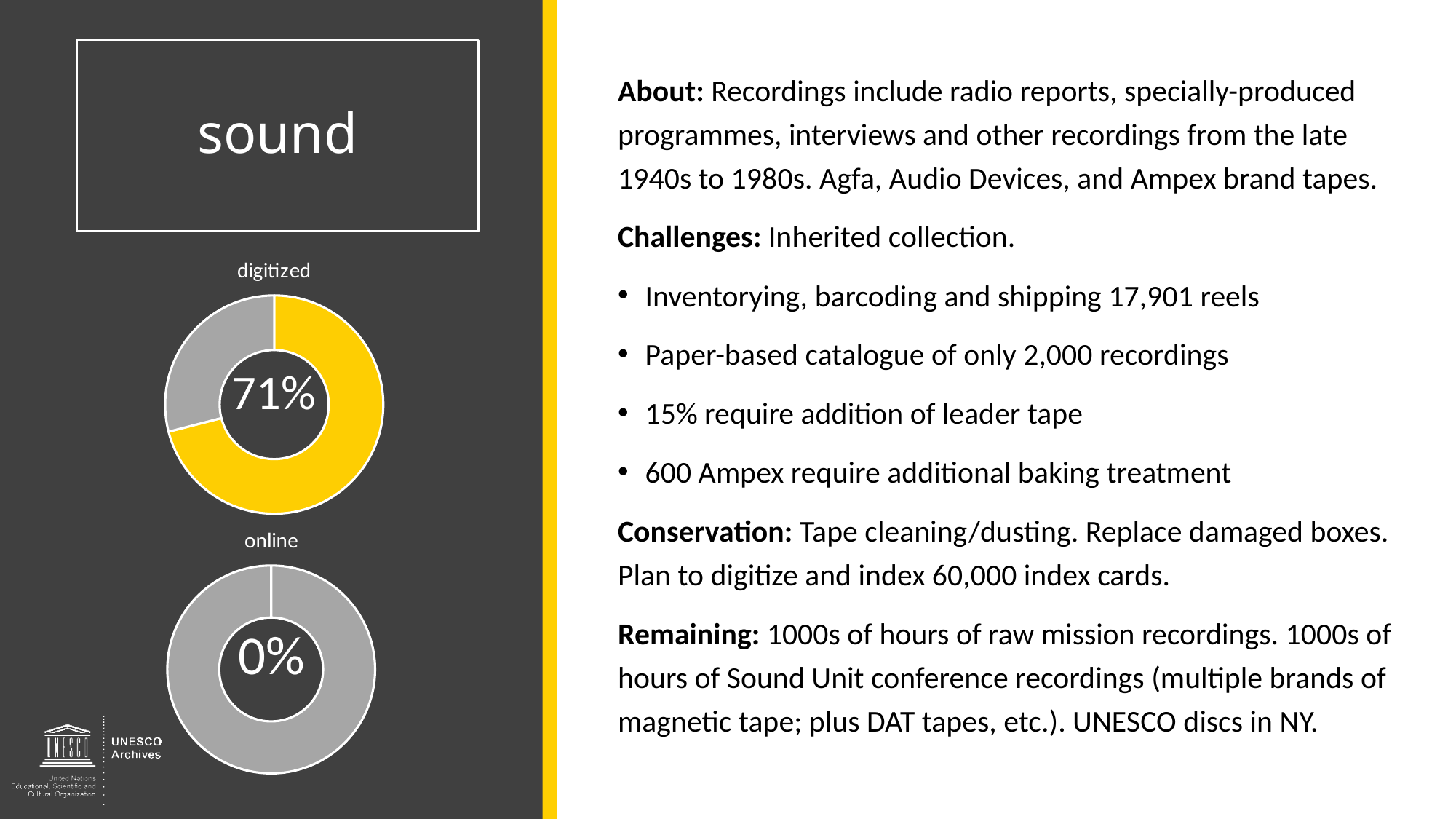
In the 'digitized' donut chart, what share of the ring is not filled in yellow (i.e. not digitized)? 29% Of the two donut charts, which one shows the lowest percentage? online How many donut charts are shown on the slide? 2 What percentage is shown in the centre of the 'online' donut chart? 0% What kind of chart is used to show the 'digitized' percentage? Donut (pie) chart What colour is the filled (digitized) portion of the 'digitized' donut chart? Yellow Which is larger, the 'digitized' percentage or the 'online' percentage? digitized What is the difference between the 'digitized' percentage and the 'online' percentage? 71% Is the value in the 'digitized' chart greater or less than 50%? greater Of the two donut charts, which one shows the highest percentage? digitized Is the value in the 'online' chart greater or less than 10%? less What percentage is shown in the centre of the 'digitized' donut chart? 71%